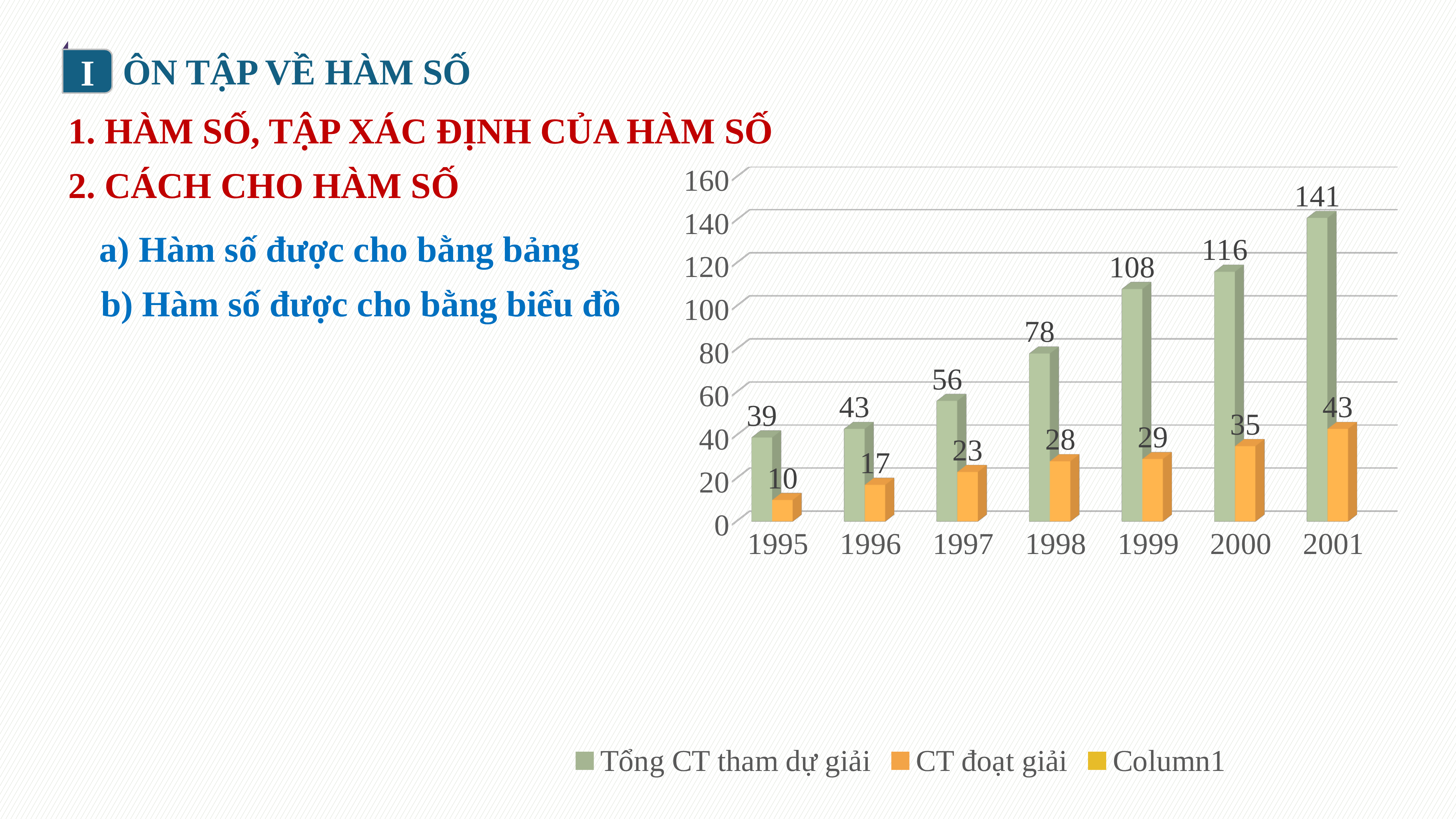
How many years are shown on the x axis? 7 Which year has the highest value for "Tổng CT tham dự giải"? 2001 What is the difference between the "Tổng CT tham dự giải" values for 2000 and 1999? 8 What kind of chart is shown on the slide? Bar chart What is the value of "Tổng CT tham dự giải" for 1998? 78 Do the values for "Tổng CT tham dự giải" rise or fall from 1995 to 2001? Rise Which is larger: "CT đoạt giải" in 1997 or "CT đoạt giải" in 1999? 1999 How many series does the legend list? 3 What is the value of "CT đoạt giải" for 2000? 35 Which year has the lowest value for "CT đoạt giải"? 1995 What is the value of "Tổng CT tham dự giải" for 1995? 39 What is the difference between "Tổng CT tham dự giải" and "CT đoạt giải" in 2001? 98